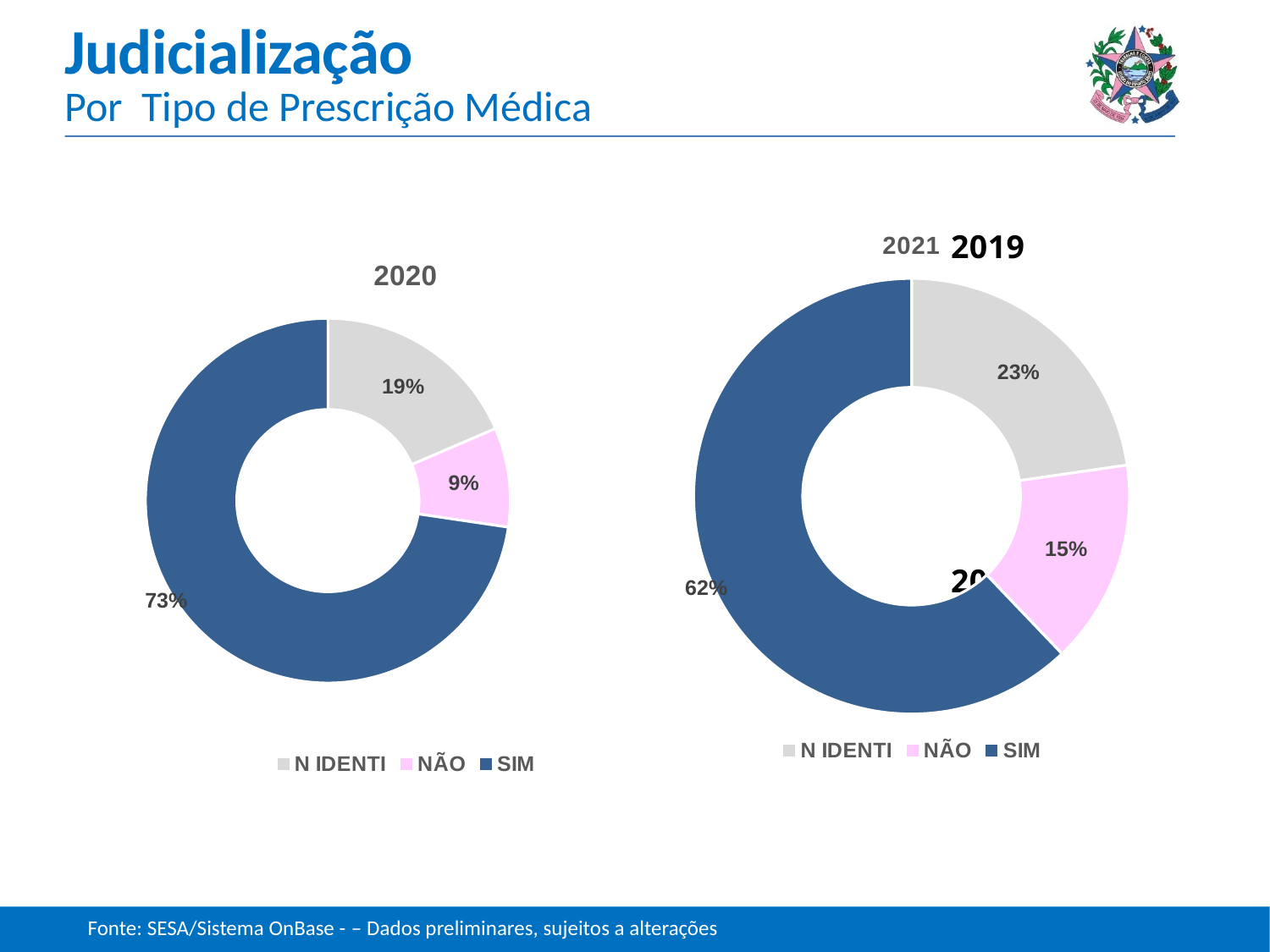
In the left chart titled 2020, which category has the largest share? SIM In the left chart titled 2020, what is the value for N IDENTI? 19% In the left chart titled 2020, what is the value for NÃO? 9% In the right chart, what is the value for N IDENTI? 23% In the right chart, what is the value for SIM? 62% In the left chart titled 2020, what is the value for SIM? 73% What type of chart is the left chart titled 2020? Donut chart Which is larger in the right chart: the share for N IDENTI or the share for NÃO? N IDENTI In the right chart, what is the value for NÃO? 15% In the left chart titled 2020, what is the difference between the SIM and N IDENTI shares? 54% In the right chart, which category has the smallest share? NÃO How many categories does the legend of the left chart titled 2020 list? 3